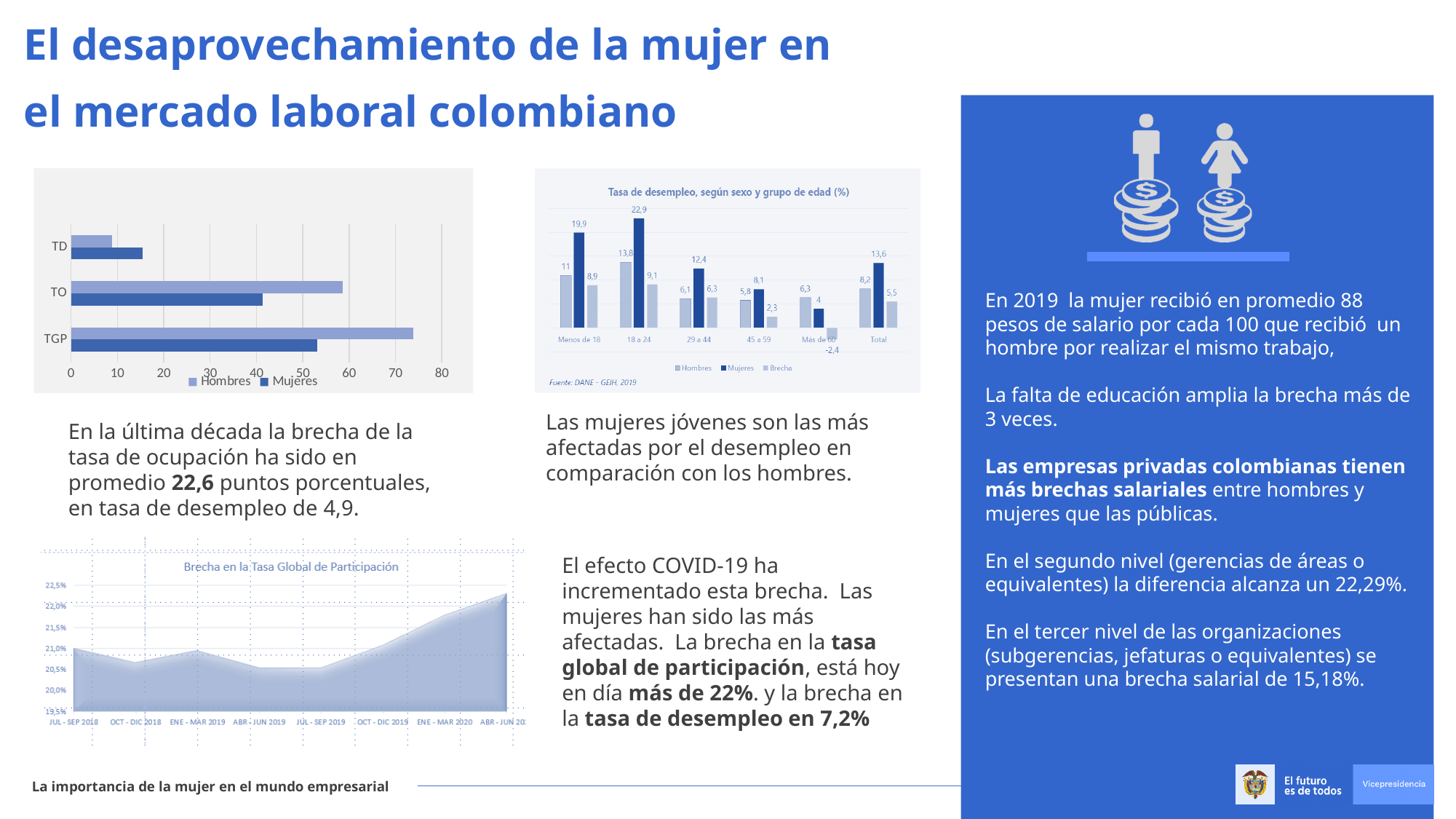
In the chart titled 'Tasa de desempleo, según sexo y grupo de edad (%)', which age group has the lowest value for Hombres? 45 a 59 In the horizontal bar chart at the top left of the slide, which is larger for TD, the Hombres value or the Mujeres value? Mujeres In the horizontal bar chart at the top left of the slide, is the Hombres value for TGP greater or less than 70? greater In the chart titled 'Tasa de desempleo, según sexo y grupo de edad (%)', how many series does the legend list? 3 In the horizontal bar chart at the top left of the slide, how many categories are shown on the vertical axis? 3 In the chart titled 'Tasa de desempleo, según sexo y grupo de edad (%)', which age group has the highest value for Mujeres? 18 a 24 What kind of chart is the chart titled 'Brecha en la Tasa Global de Participación'? Area chart In the horizontal bar chart at the top left of the slide, is the Hombres value for TD greater or less than 10? less In the chart titled 'Tasa de desempleo, según sexo y grupo de edad (%)', what is the value for Mujeres in the '18 a 24' group? 22,9 In the chart titled 'Tasa de desempleo, según sexo y grupo de edad (%)', what is the Brecha value for the 'Más de 60' group? -2,4 In the chart titled 'Tasa de desempleo, según sexo y grupo de edad (%)', what is the difference between the Mujeres and Hombres values for the '18 a 24' group? 9,1 In the chart titled 'Brecha en la Tasa Global de Participación', is the value for ABR - JUN 2020 greater or less than 22,0%? greater